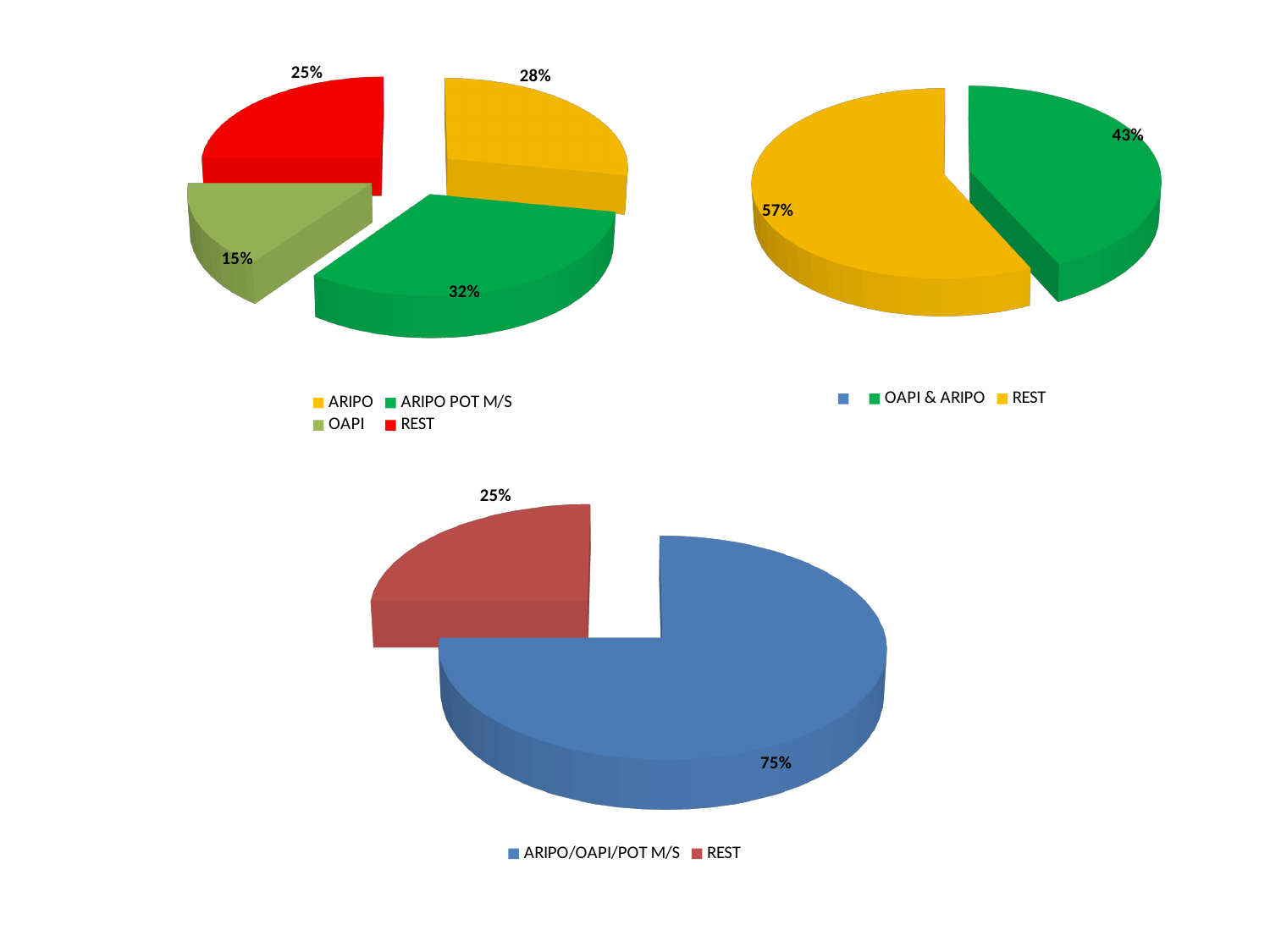
In the top-left pie chart, what share does OAPI have? 15% In the top-left pie chart, what is the difference between the ARIPO and REST shares? 3% In the bottom pie chart, what is the difference between the ARIPO/OAPI/POT M/S and REST shares? 50% In the top-left pie chart, which category has the largest slice? ARIPO POT M/S In the bottom pie chart, what colour is the REST slice? Red In the top-right pie chart, what share does REST have? 57% In the bottom pie chart, what share does ARIPO/OAPI/POT M/S have? 75% In the top-left pie chart, what share does ARIPO POT M/S have? 32% What kind of chart is the bottom chart? Pie chart In the top-left pie chart, which category has the smallest slice? OAPI In the top-right pie chart, which is larger, OAPI & ARIPO or REST? REST In the top-left pie chart, how many slices are there? 4